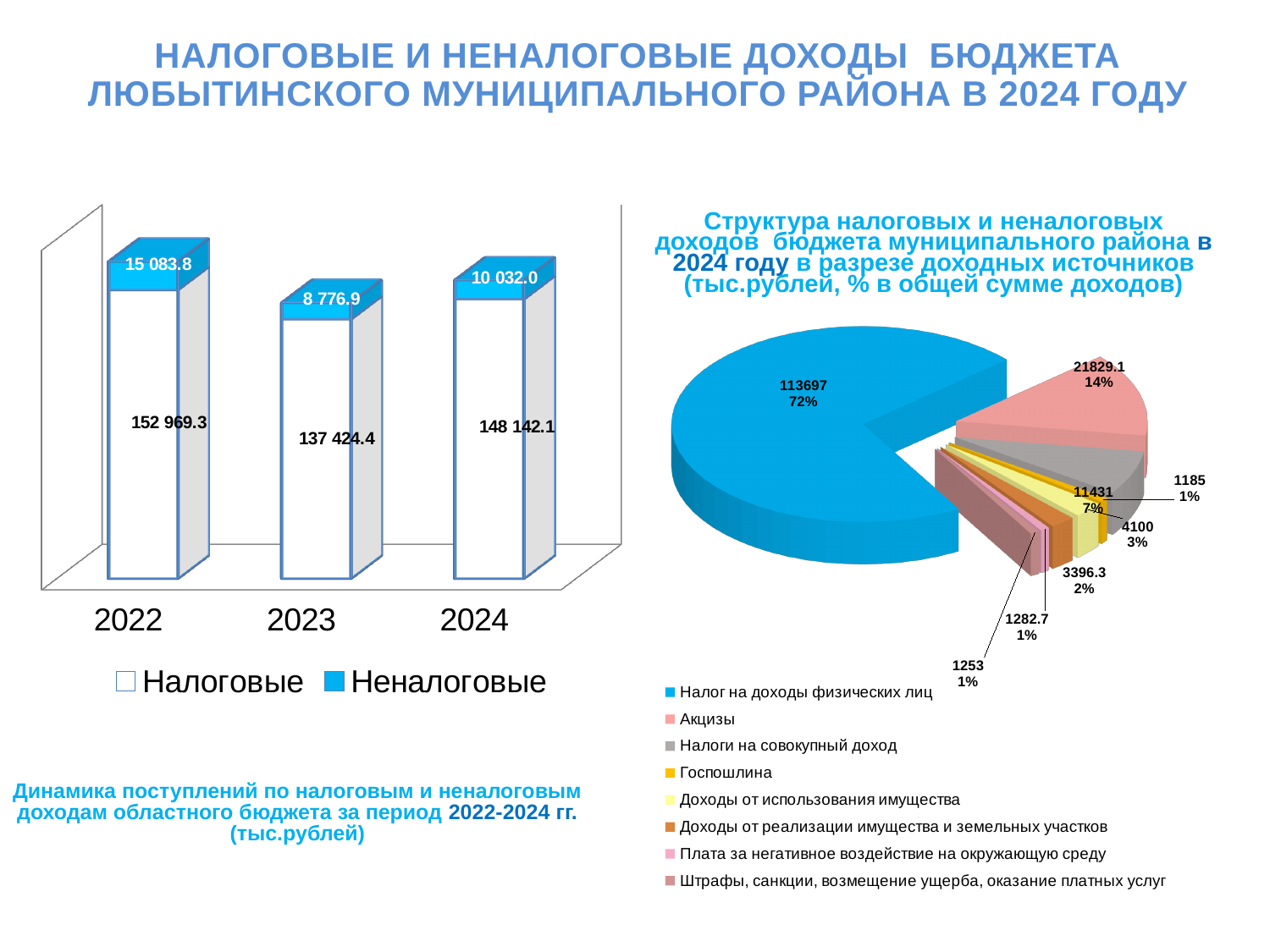
On the right pie chart, what is the value for Акцизы? 21829.1 On the left bar chart, what is the value for Неналоговые in 2024? 10 032.0 On the left bar chart, what is the value for Налоговые in 2022? 152 969.3 On the right pie chart, what share of the total is Налог на доходы физических лиц? 72% On the right pie chart, how many categories does the legend list? 8 On the left bar chart, which year has the highest value for Неналоговые? 2022 On the left bar chart, what is the total of the stacked bar for 2022? 168 053.1 What kind of chart is shown on the right side of the slide? Pie chart On the left bar chart, how many series does the legend list? 2 On the left bar chart, what is the value for Неналоговые in 2023? 8 776.9 On the left bar chart, which year has the lowest value for Налоговые? 2023 On the left bar chart, what is the difference between the Налоговые values for 2022 and 2023? 15 544.9